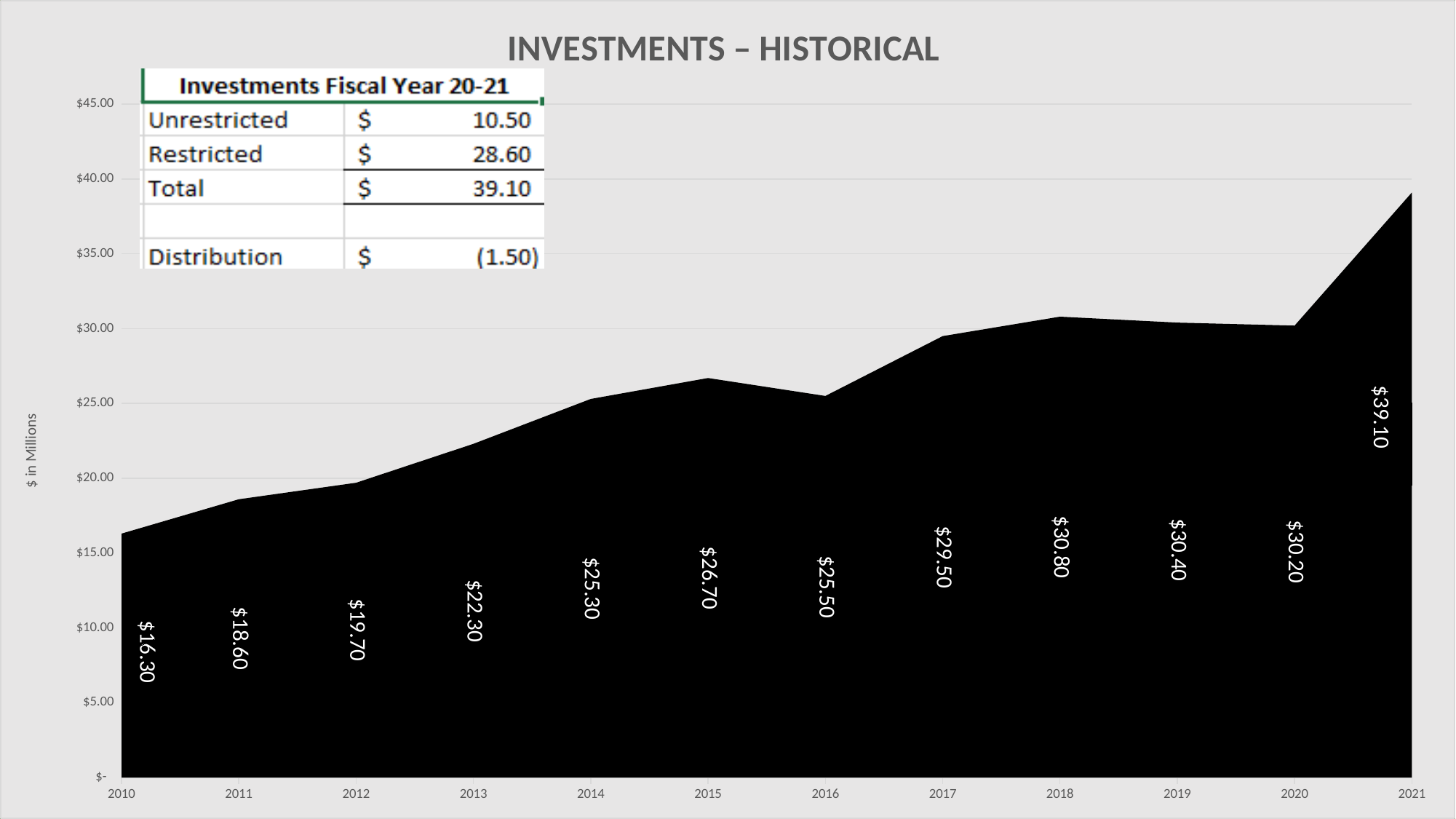
What is the investment value for 2016? $25.50 Is the investment value for 2018 greater or less than $30.00? greater Which year has the highest investment value? 2021 What is the investment value for 2010? $16.30 Which year has a larger investment value, 2015 or 2016? 2015 How many years are plotted on the chart? 12 What is the title of the chart? INVESTMENTS – HISTORICAL What is the investment value for 2021? $39.10 What kind of chart is shown on the slide? area chart Which year has the lowest investment value? 2010 Do the investment values generally rise or fall from 2010 to 2021? rise What is the difference between the investment values for 2021 and 2020? $8.90